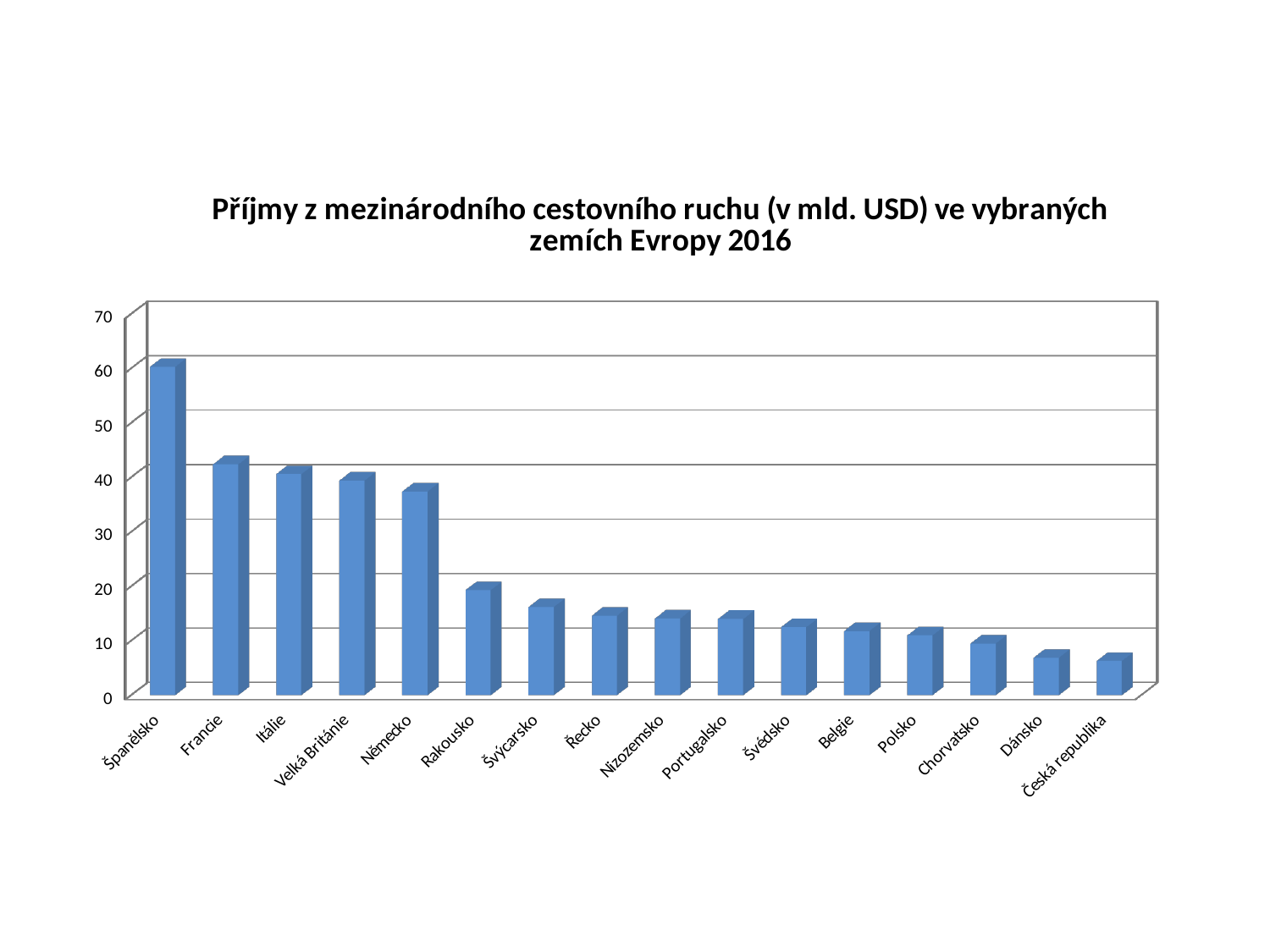
Is the value for Německo greater or less than 30? greater Is the value for Švýcarsko greater or less than 20? less Is the value for Španělsko greater or less than 50? greater Which country has the highest value on the chart? Španělsko What kind of chart is shown on the slide? bar chart Do the values rise or fall from left to right along the x axis? fall Which has a larger value, Německo or Rakousko? Německo Which has a larger value, Španělsko or Francie? Španělsko How many countries are shown on the chart? 16 Which country has the lowest value on the chart? Česká republika